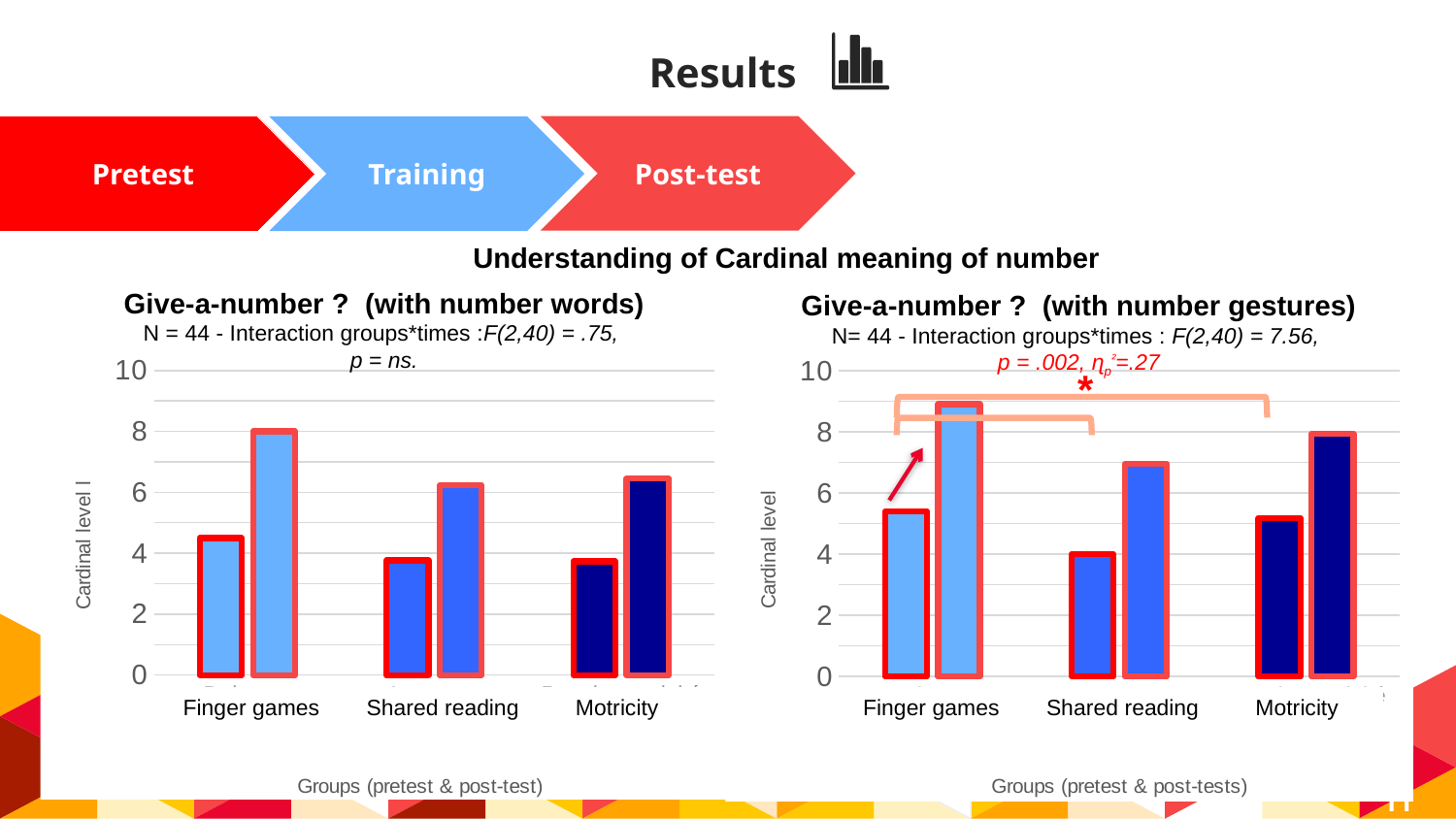
In the right chart (with number gestures), is the post-test value for Finger games greater or less than 8? greater In the left chart (with number words), which is larger: the post-test value for Finger games or the post-test value for Shared reading? Finger games In the right chart (with number gestures), is the post-test value for Shared reading greater or less than 6? greater In the left chart (with number words), is the pretest value for Shared reading greater or less than 6? less How many groups are shown on the x axis of the 'Give-a-number ? (with number gestures)' chart on the right? 3 In the right chart (with number gestures), which group has the lowest pretest bar? Shared reading What kind of chart is the 'Give-a-number ? (with number words)' chart on the left? bar chart In the right chart (with number gestures), which group has the highest post-test bar? Finger games What is the y-axis label of the right chart (with number gestures)? Cardinal level In the right chart (with number gestures), which is larger: the pretest value for Finger games or the pretest value for Shared reading? Finger games